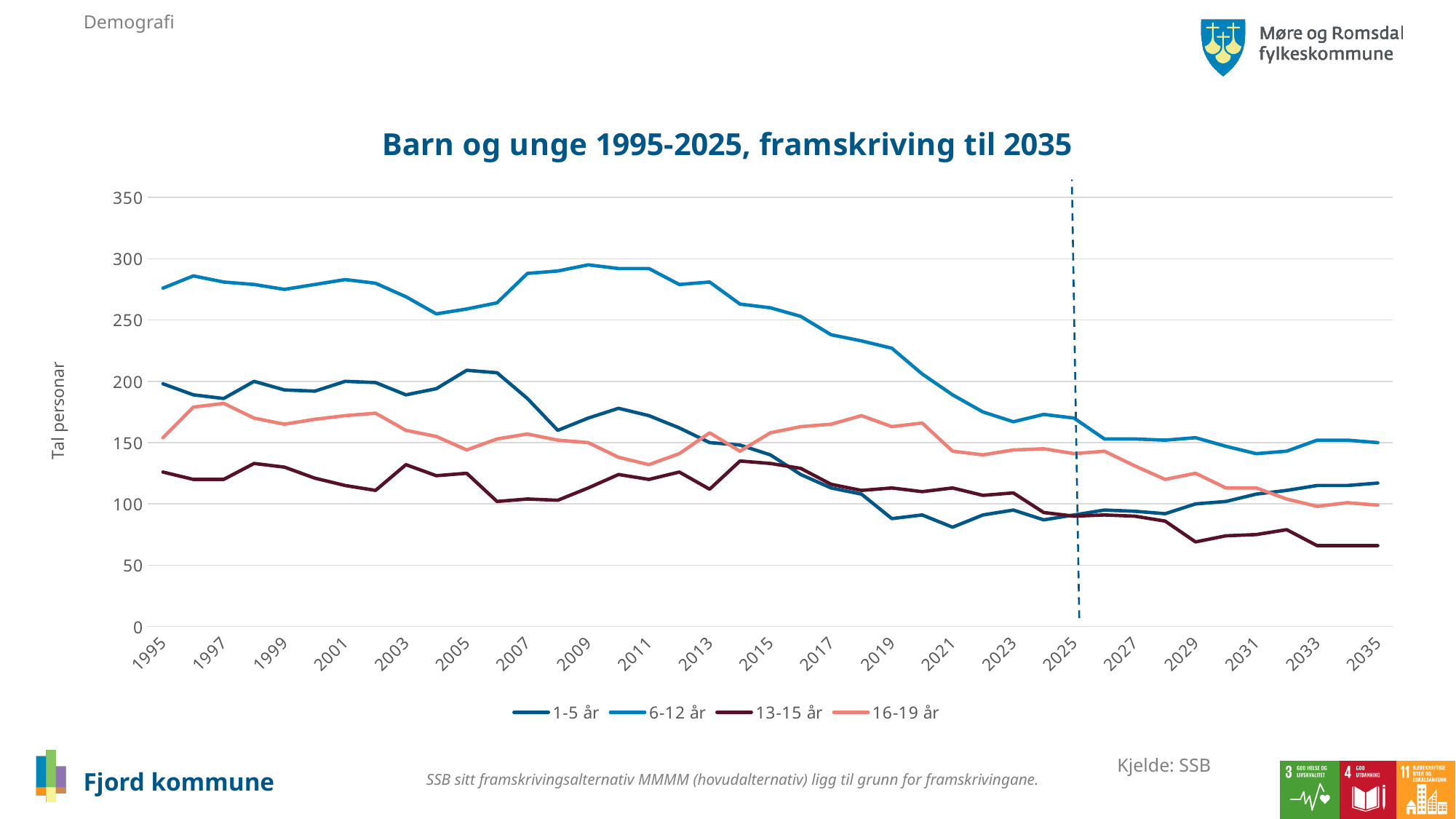
Is the value for 13-15 år in 2035 greater or less than 100? less Which series has the highest value in 2025? 6-12 år How many series does the legend list? 4 In 1995, which is larger: the value for 6-12 år or the value for 1-5 år? 6-12 år What kind of chart is shown on the slide? line chart Is the value for 16-19 år in 1997 greater or less than 150? greater What is the label on the vertical axis? Tal personar Is the value for 1-5 år in 2019 greater or less than 100? less Which series has the lowest value in 2035? 13-15 år Does the 6-12 år series rise or fall from 2009 to 2035? fall What is the title of the chart? Barn og unge 1995-2025, framskriving til 2035